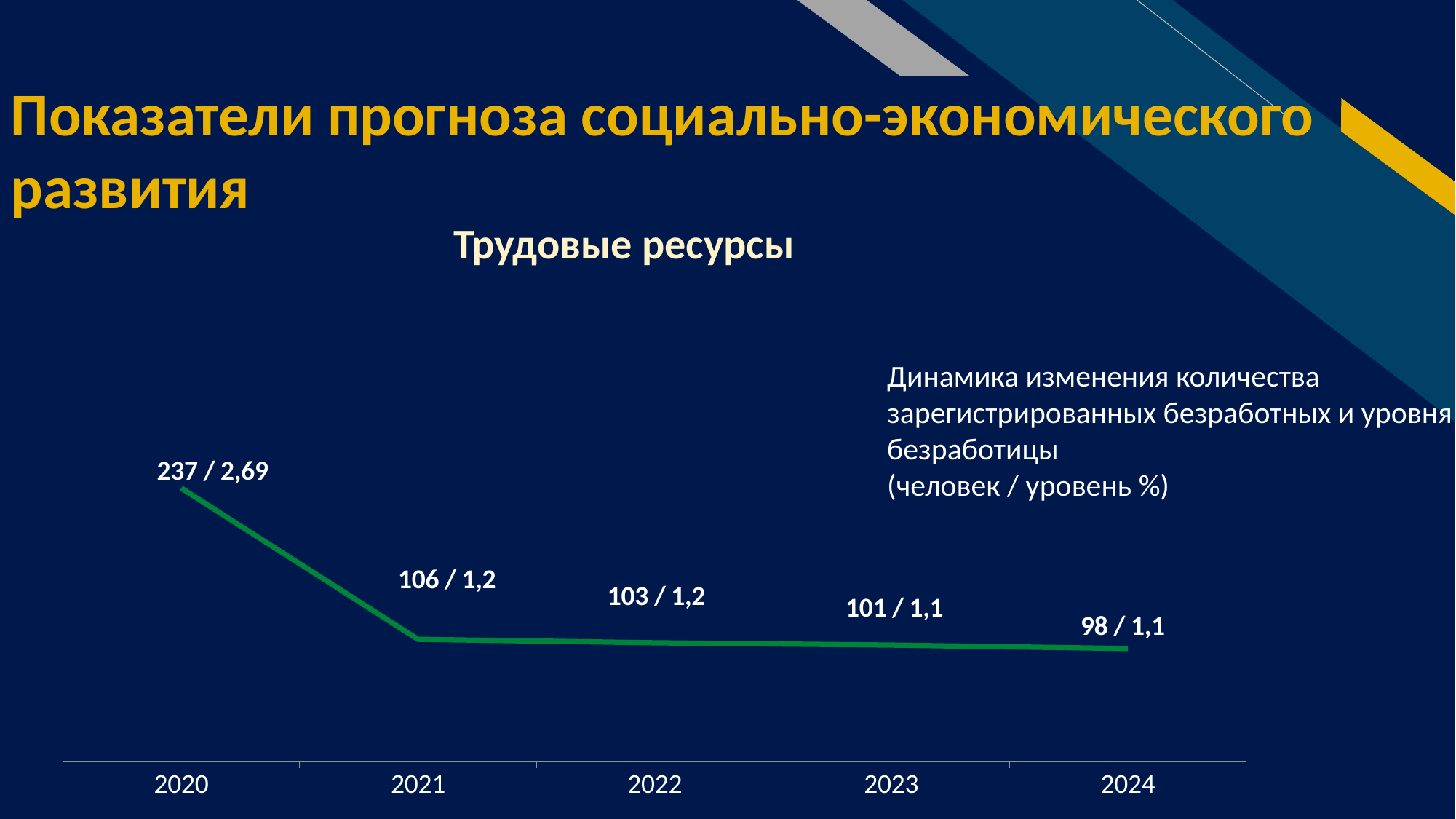
What is the number of registered unemployed (first number in the label) for 2023? 101 What is the data label shown for 2024 on the chart? 98 / 1,1 By how much does the number of registered unemployed fall from 2020 to 2021? 131 How many years are plotted on the x axis of the chart? 5 What is the data label shown for 2022 on the chart? 103 / 1,2 Which year has a larger number of registered unemployed, 2022 or 2023? 2022 What is the difference in the number of registered unemployed between 2021 and 2024? 8 What type of chart is shown on the slide? Line chart What is the unemployment rate (second number in the label) for 2021? 1,2 What is the data label shown for 2020 on the chart? 237 / 2,69 Which year has the lowest number of registered unemployed? 2024 Which year has the highest number of registered unemployed? 2020